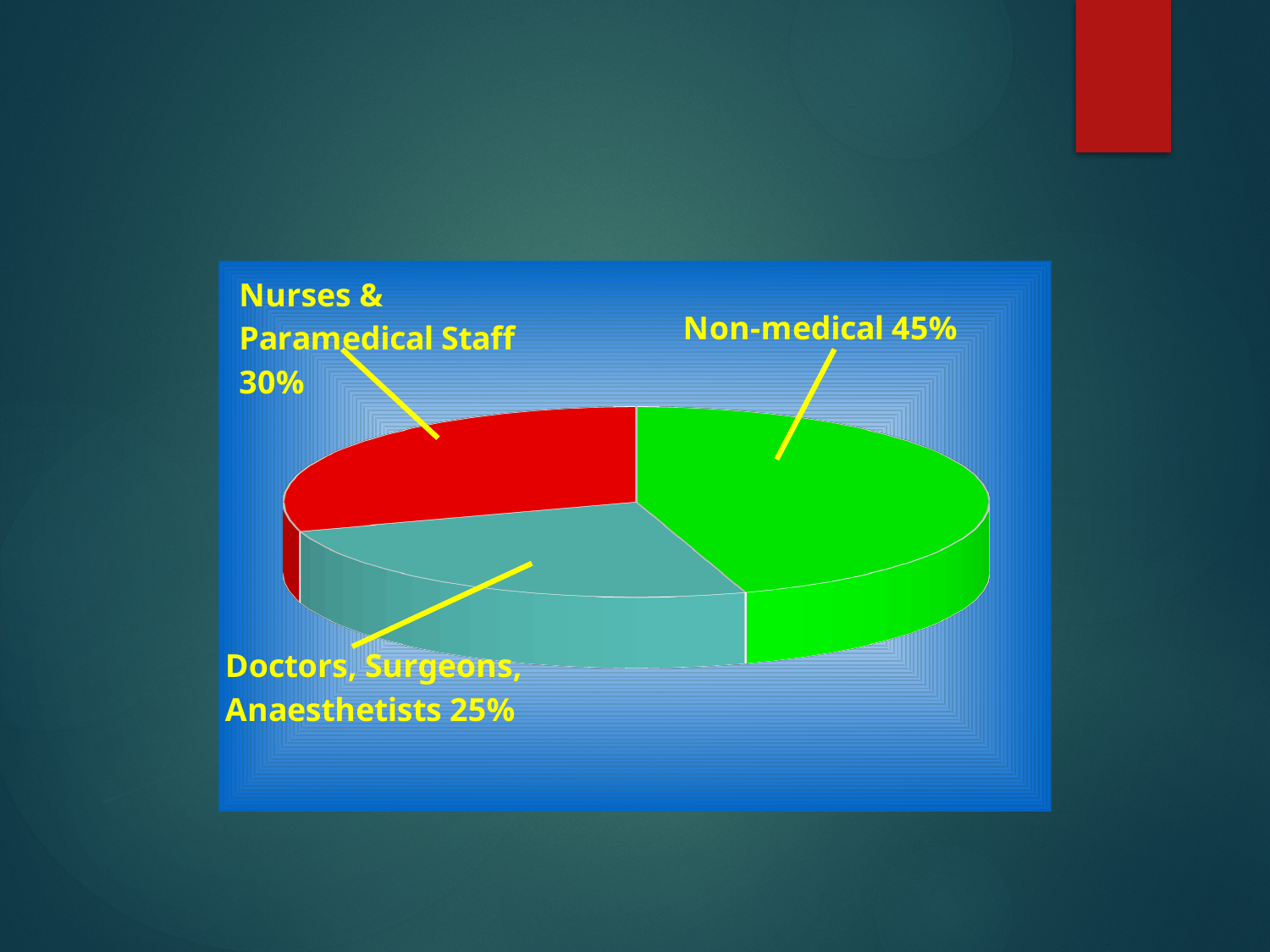
What share of the pie is Non-medical? 45% What is the difference in percentage points between Non-medical and Nurses & Paramedical Staff? 15% How many slices does the pie chart have? 3 What share of the pie is Doctors, Surgeons, Anaesthetists? 25% What is the difference in percentage points between Nurses & Paramedical Staff and Doctors, Surgeons, Anaesthetists? 5% Which is larger, the Non-medical slice or the Doctors, Surgeons, Anaesthetists slice? Non-medical What colour is the Nurses & Paramedical Staff slice? Red Which category has the smallest slice of the pie? Doctors, Surgeons, Anaesthetists Which category has the largest slice of the pie? Non-medical What kind of chart is shown on the slide? Pie chart What colour is the Non-medical slice? Green What share of the pie is Nurses & Paramedical Staff? 30%